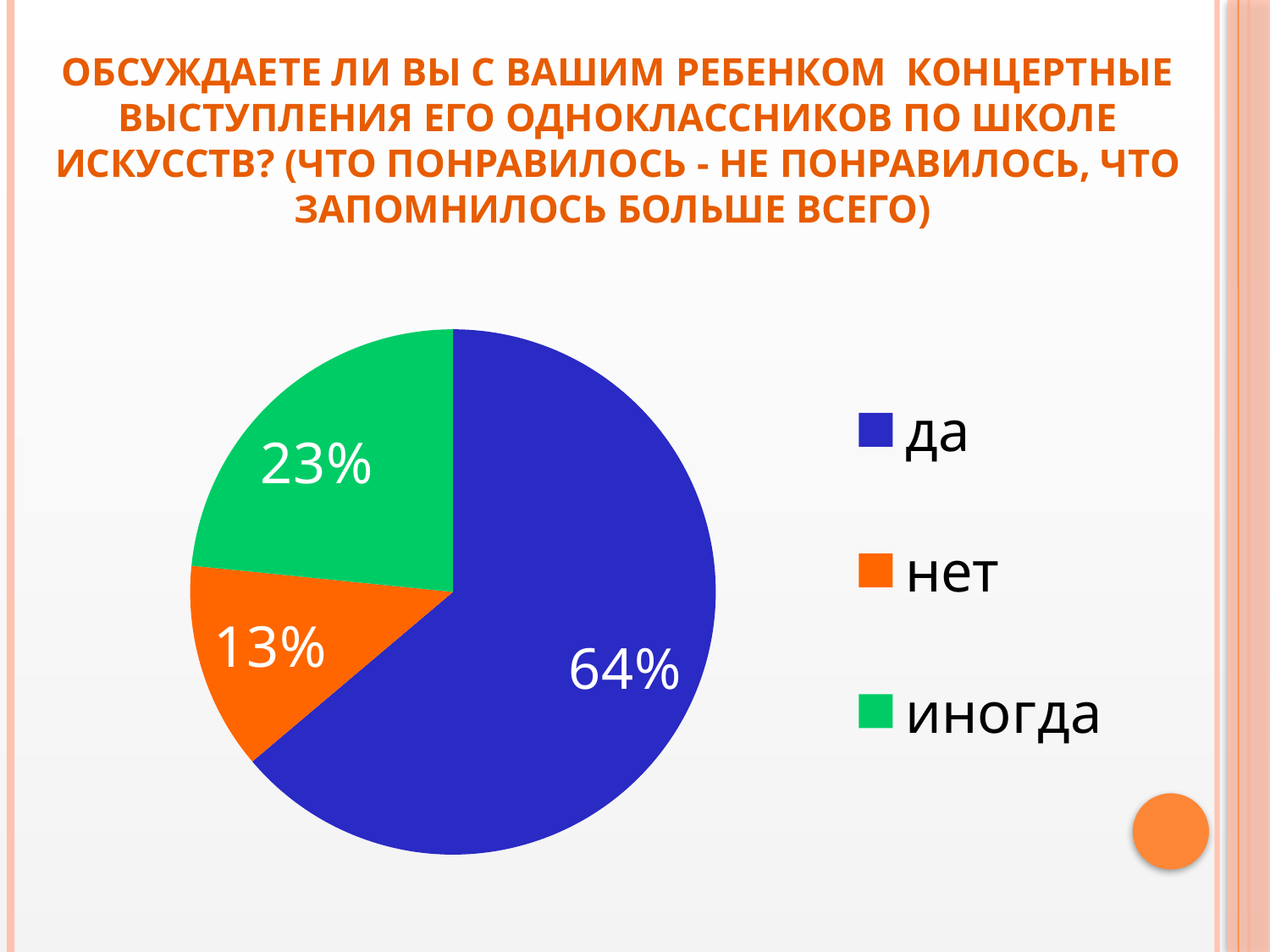
What share of the pie does "нет" take? 13% Which is larger, the share for "нет" or the share for "иногда"? иногда What share of the pie does "иногда" take? 23% How many entries does the legend list? 3 What share of the pie does "да" take? 64% Which category has the largest slice of the pie? да How many slices does the pie chart have? 3 What colour is the slice for "иногда"? green Which category has the smallest slice of the pie? нет What kind of chart is shown on the slide? pie chart What is the difference in percentage points between "да" and "иногда"? 41 What is the difference in percentage points between "иногда" and "нет"? 10